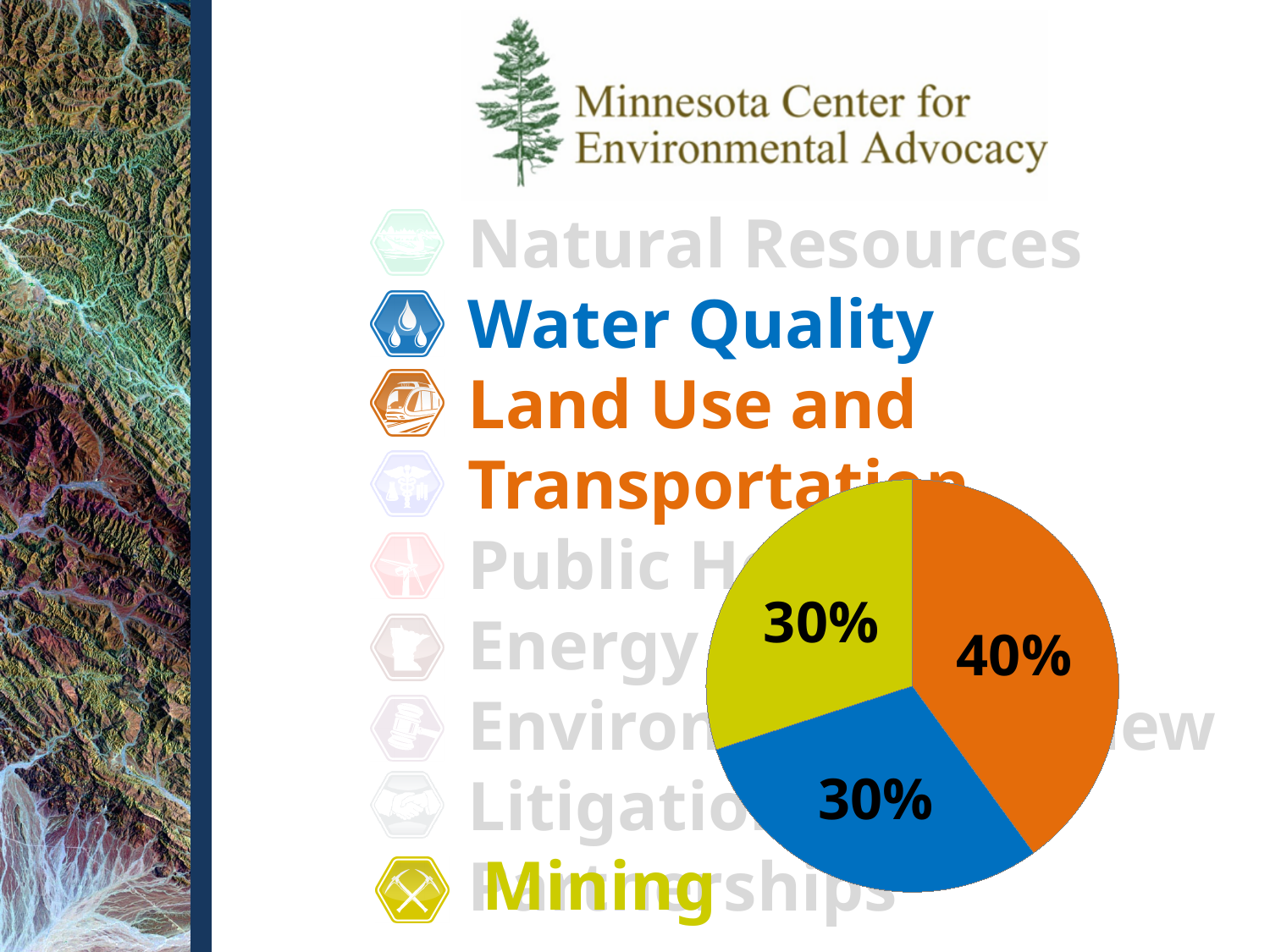
Does the pie chart include a legend? No Which slice of the pie chart is the largest? The orange slice (40%) Which is larger in the pie chart, the orange slice or the yellow slice? The orange slice How many slices in the pie chart show the value 30%? 2 What percentage is shown on the orange slice of the pie chart? 40% What share of the pie does the largest slice represent? 40% What kind of chart is shown on the slide? Pie chart What do the three slice percentages in the pie chart add up to? 100% What percentage is shown on the yellow slice of the pie chart? 30% What percentage is shown on the blue slice of the pie chart? 30% How many slices does the pie chart have? 3 What is the difference between the orange slice and the blue slice in the pie chart? 10 percentage points